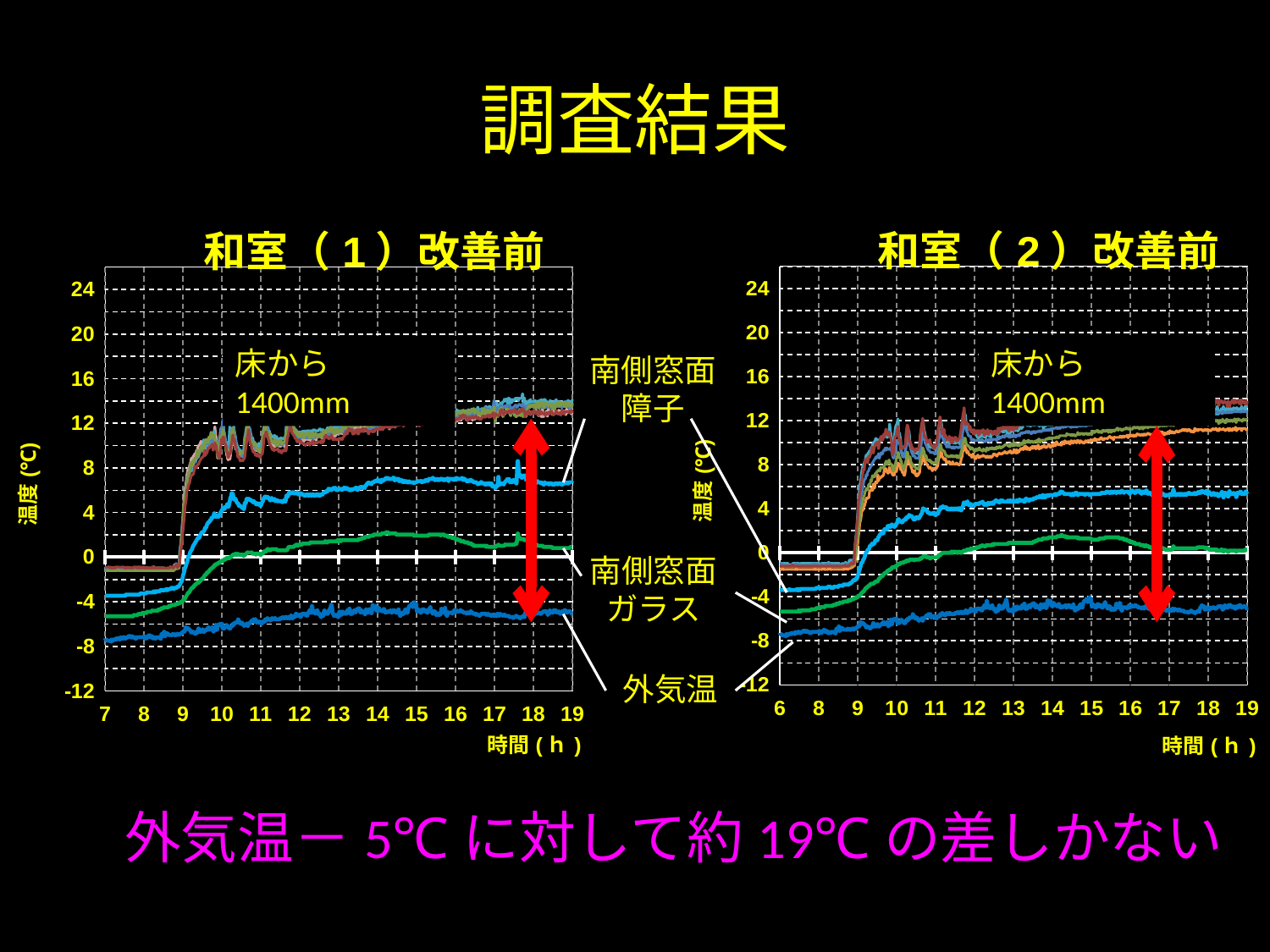
What kind of chart is the 和室（1）改善前 chart? line chart On the 和室（2）改善前 chart, is the 外気温 value at 17 h greater or less than 0? less On the 和室（1）改善前 chart, what is the label of the vertical axis? 温度 (℃) On the 和室（2）改善前 chart, what is the label of the horizontal axis? 時間 ( h ) On the 和室（1）改善前 chart, is the 南側窓面ガラス value at 14 h greater or less than 0? greater On the 和室（2）改善前 chart, at 12 h, which is larger: 南側窓面障子 or 南側窓面ガラス? 南側窓面障子 On the 和室（2）改善前 chart, is the 南側窓面障子 value at 18 h greater or less than 4? greater On the 和室（1）改善前 chart, at 18 h, which is larger: 床から1400mm or 外気温? 床から1400mm On the 和室（1）改善前 chart, does the 外気温 line rise or fall from 7 h to 19 h? rise